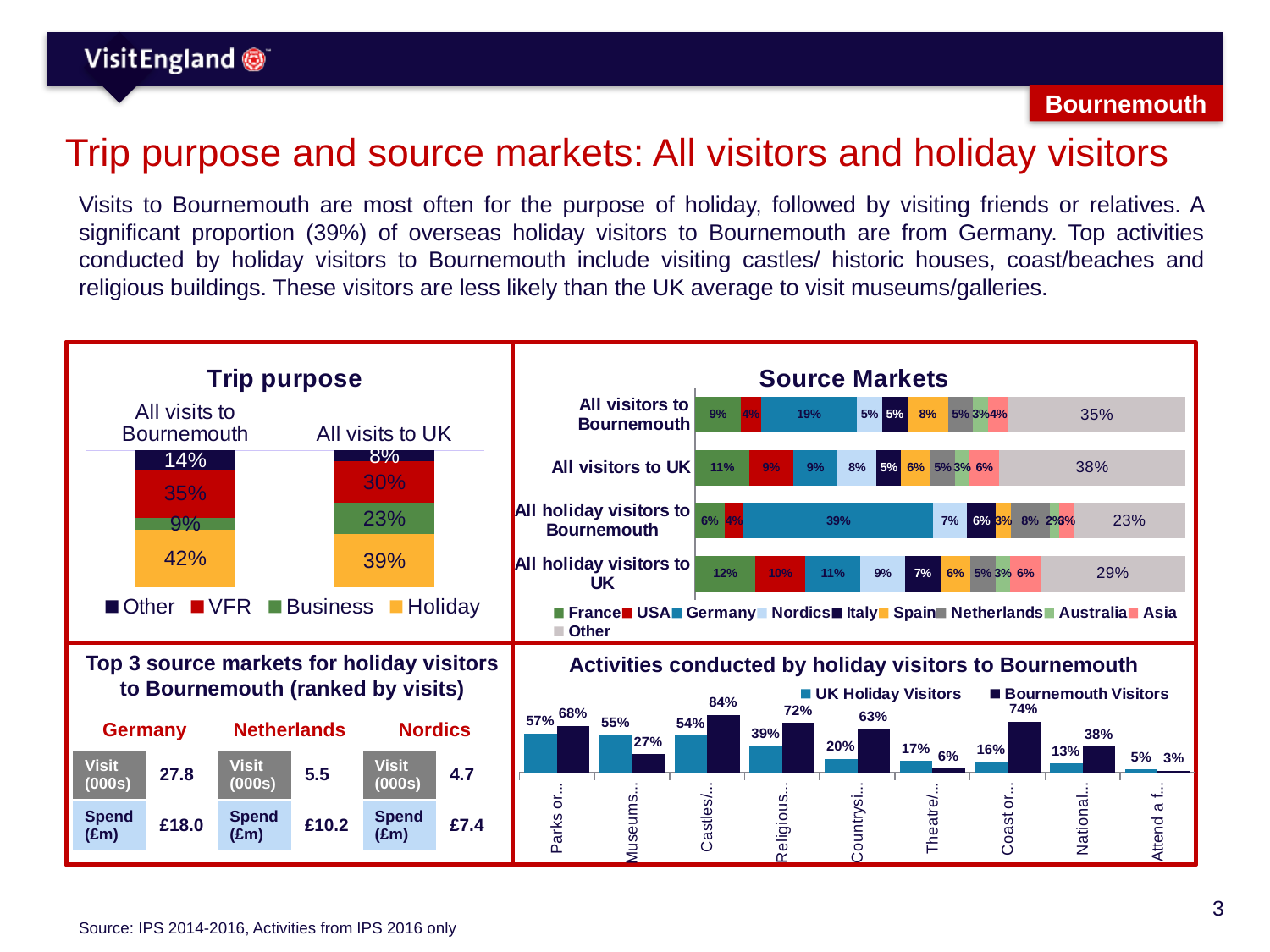
In the Trip purpose chart, what percentage of all visits to the UK are for Business? 23% In the Activities chart, which is larger for museums: UK Holiday Visitors or Bournemouth Visitors? UK Holiday Visitors What type of chart is the Activities conducted by holiday visitors to Bournemouth chart? Bar chart In the Activities chart, what percentage of Bournemouth Visitors visit castles? 84% In the Source Markets chart, what share of all holiday visitors to Bournemouth come from Germany? 39% In the Activities chart, what is the difference between Bournemouth Visitors and UK Holiday Visitors for the coast activity? 58% In the Trip purpose chart, what percentage of all visits to Bournemouth are for Holiday? 42% In the Trip purpose chart, what is the difference between the VFR share for all visits to Bournemouth and for all visits to the UK? 5% How many series does the legend of the Trip purpose chart list? 4 In the Source Markets chart, what share of all visitors to the UK falls in the Other category? 38% In the Source Markets chart, which source market is the largest named market for all visitors to Bournemouth? Germany How many categories (bars) does the Source Markets chart show? 4